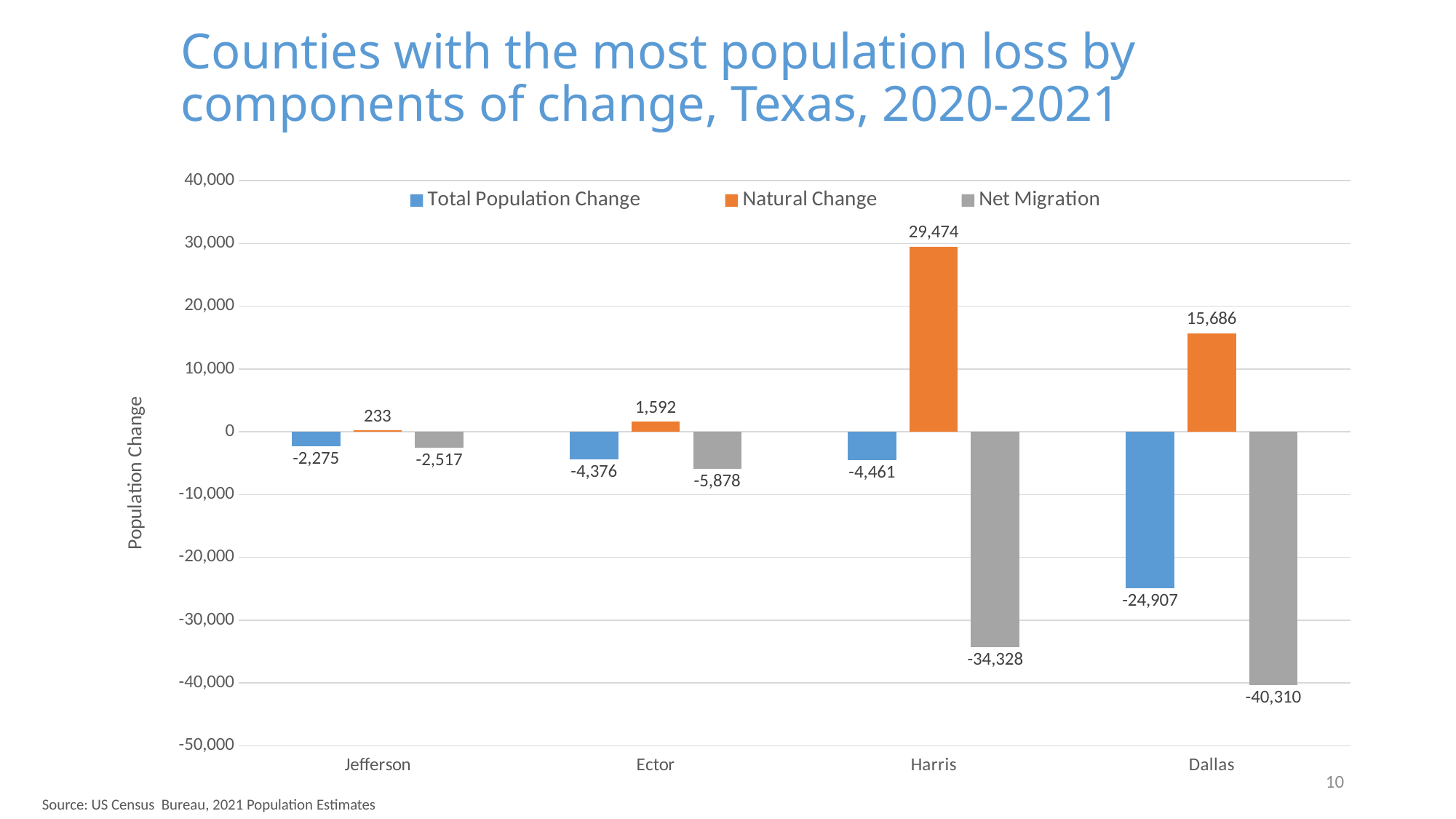
What kind of chart is shown on the slide? Bar chart What is the Natural Change value for Harris? 29,474 How many series does the legend list? 3 What is the Net Migration value for Ector? -5,878 How many counties are shown on the x axis? 4 What is the difference between the Natural Change values for Harris and Dallas? 13,788 What is the Total Population Change for Dallas? -24,907 Which is larger, the Total Population Change for Jefferson or for Ector? Jefferson Which series is shown in orange in the legend? Natural Change What is the Natural Change value for Jefferson? 233 Which county has the highest Natural Change value? Harris Which county has the lowest Net Migration value? Dallas